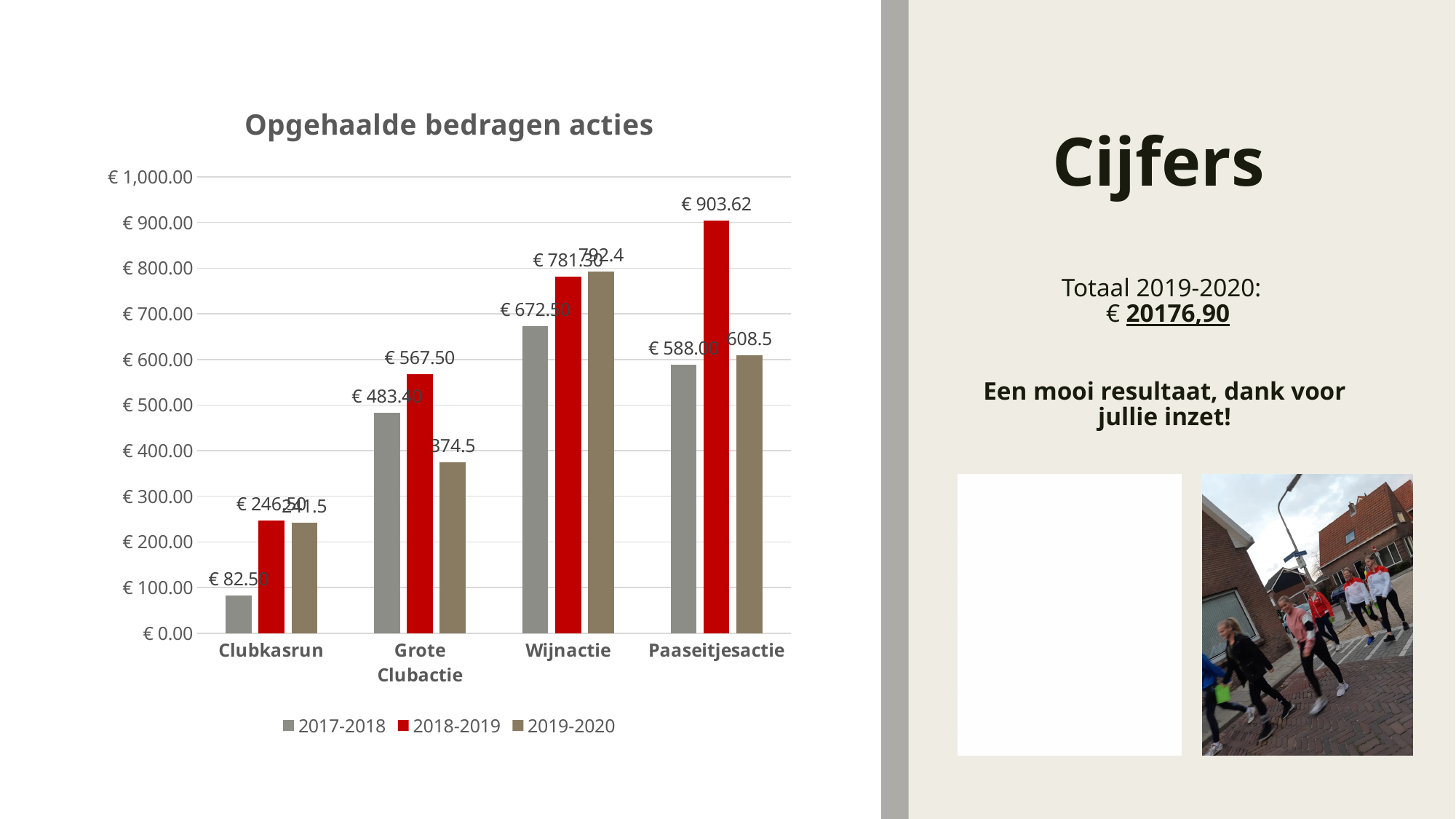
What amount is shown for Paaseitjesactie in the 2018-2019 series? € 903.62 What amount is shown for Wijnactie in the 2017-2018 series? € 672.50 What value is labelled for Grote Clubactie in the 2019-2020 series? 374.5 How many series does the legend list? 3 What amount did the Clubkasrun raise in 2017-2018? € 82.50 For Grote Clubactie, which is larger: the 2017-2018 value or the 2019-2020 value? 2017-2018 Which category has the lowest value in the 2019-2020 series? Clubkasrun Which category has the highest value in the 2017-2018 series? Wijnactie How many categories (acties) are shown on the x axis? 4 What type of chart is shown on the slide? bar chart What is the difference between the 2018-2019 and 2017-2018 values for Paaseitjesactie? € 315.62 Is the 2019-2020 value for Wijnactie greater or less than € 700.00? greater